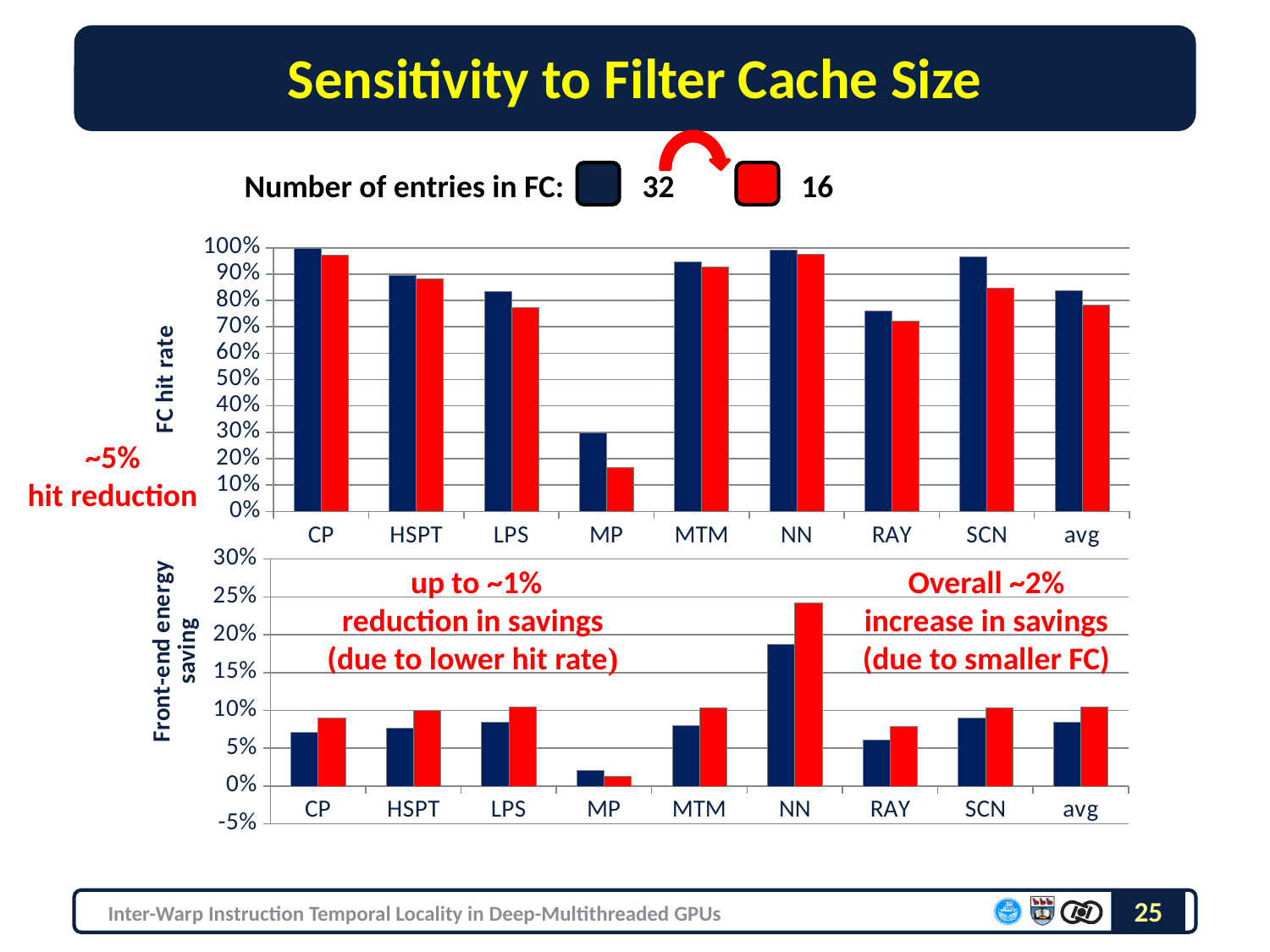
In the bottom chart (Front-end energy saving), which category has the lowest value for the 32-entry series? MP What kind of chart is the top chart (FC hit rate)? bar chart In the bottom chart (Front-end energy saving), which is larger for MP: the 32-entry bar or the 16-entry bar? 32 What is the y-axis label of the top chart? FC hit rate In the top chart (FC hit rate), is the value for MP with 16 entries greater or less than 20%? less In the top chart (FC hit rate), which is larger for HSPT: the 32-entry bar or the 16-entry bar? 32 In the bottom chart (Front-end energy saving), is the value for NN with 16 entries greater or less than 20%? greater In the top chart (FC hit rate), is the value for RAY with 32 entries greater or less than 80%? less In the bottom chart (Front-end energy saving), which category has the highest value for the 16-entry series? NN How many categories are shown on the x axis of the bottom chart (Front-end energy saving)? 9 How many series does the legend list for the charts? 2 In the top chart (FC hit rate), which category has the lowest hit rate for the 32-entry series? MP